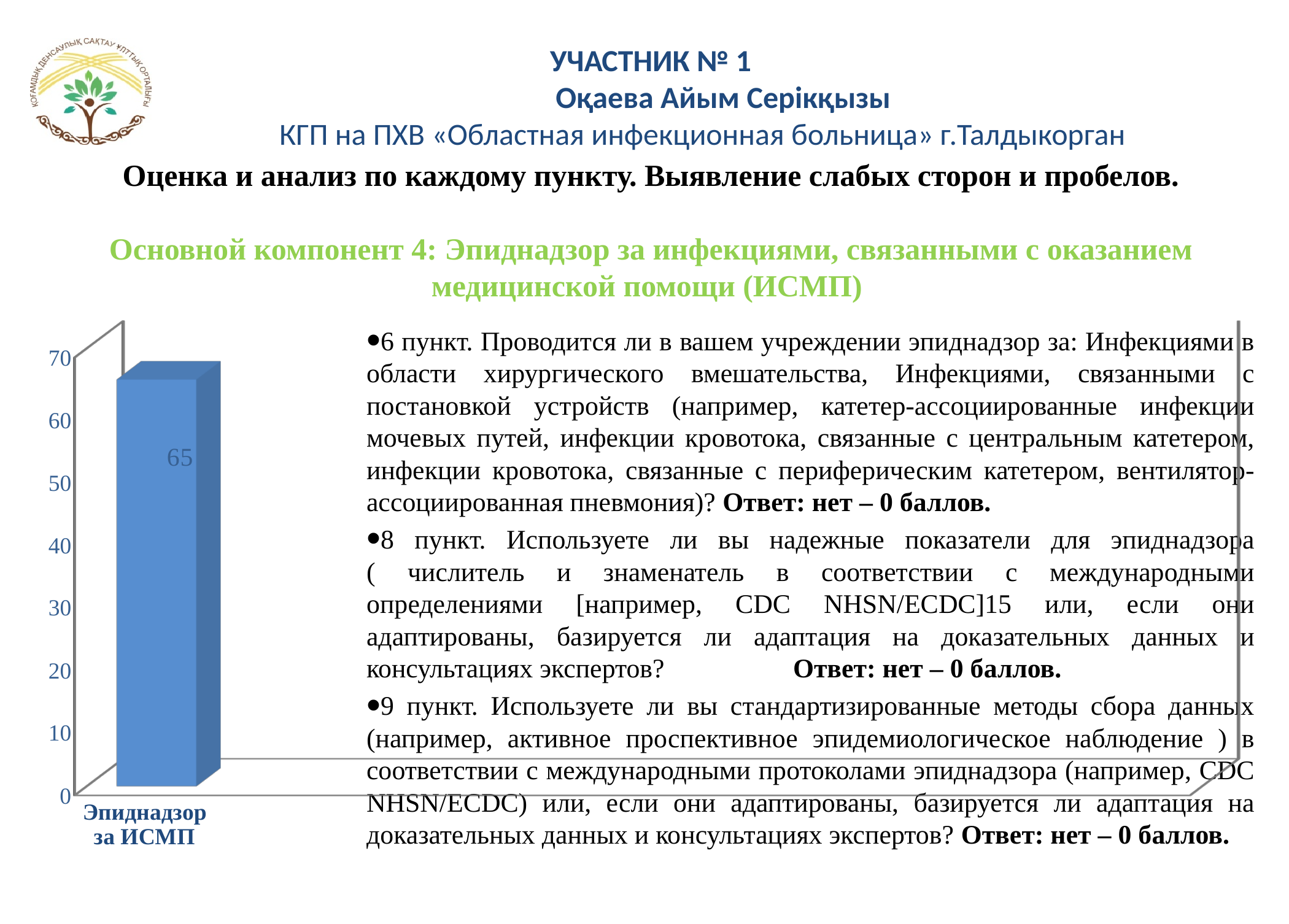
What kind of chart is shown on the left of the slide? bar chart How many categories are plotted in the bar chart? 1 Is the value for "Эпиднадзор за ИСМП" greater or less than 60? greater What is the highest tick value shown on the vertical axis of the bar chart? 70 Is the value for "Эпиднадзор за ИСМП" greater or less than 70? less What is the label of the category on the x axis of the bar chart? Эпиднадзор за ИСМП What colour is the bar in the chart? blue What is the value shown for "Эпиднадзор за ИСМП" in the bar chart? 65